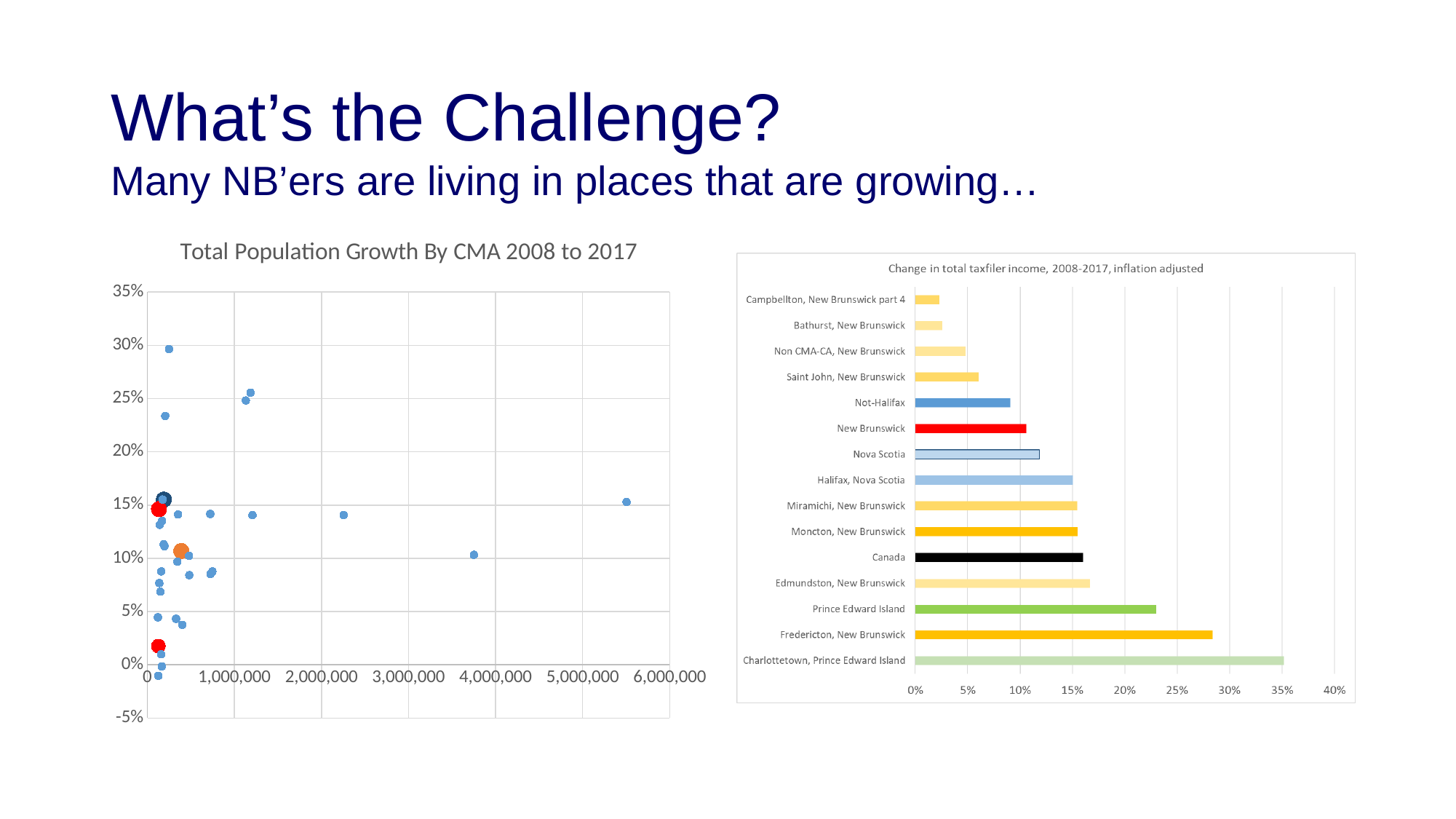
In the 'Change in total taxfiler income' chart, which category has the lowest value? Campbellton, New Brunswick part 4 In the 'Total Population Growth By CMA 2008 to 2017' chart, is the growth value for the point at roughly 5,500,000 population greater or less than 10%? greater In the 'Change in total taxfiler income' chart, is the value for Fredericton, New Brunswick greater or less than 25%? greater In the 'Change in total taxfiler income' chart, which category has the highest value? Charlottetown, Prince Edward Island In the 'Change in total taxfiler income' chart, what colour is the bar for New Brunswick? red What kind of chart is the chart on the left, titled 'Total Population Growth By CMA 2008 to 2017'? scatter chart In the 'Change in total taxfiler income' chart, how many categories are shown? 15 In the 'Change in total taxfiler income' chart, is the value for Not-Halifax greater or less than 10%? less In the 'Change in total taxfiler income' chart, which is larger: the value for Fredericton, New Brunswick or the value for Moncton, New Brunswick? Fredericton, New Brunswick What kind of chart is the chart on the right, titled 'Change in total taxfiler income, 2008-2017, inflation adjusted'? bar chart In the 'Change in total taxfiler income' chart, which is larger: the value for Canada or the value for New Brunswick? Canada